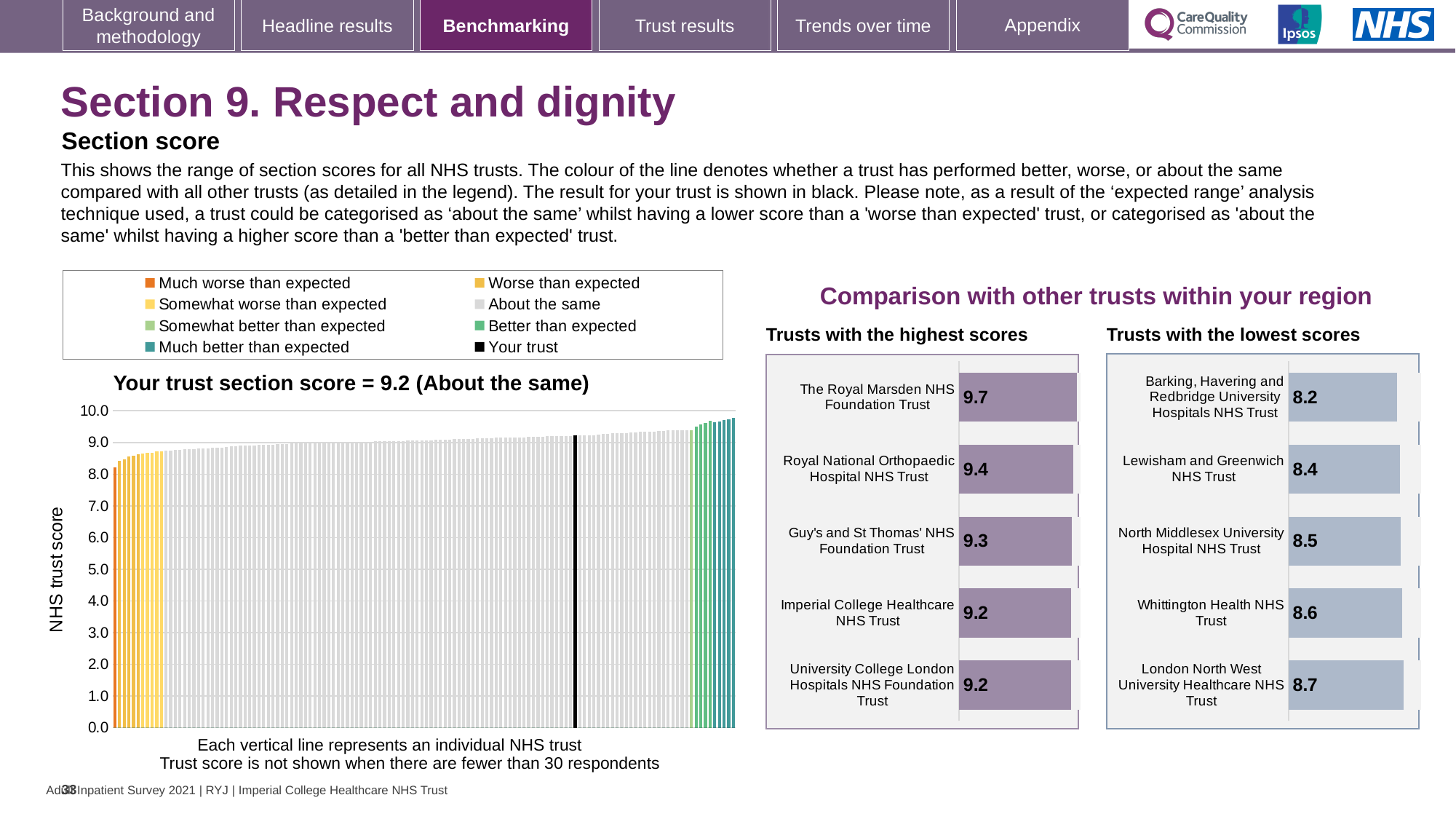
In the 'Your trust section score' chart on the left, what is the label on the vertical axis? NHS trust score In the 'Your trust section score' chart on the left, what is the section score for your trust? 9.2 In the 'Trusts with the highest scores' chart, what is the score for The Royal Marsden NHS Foundation Trust? 9.7 In the 'Trusts with the highest scores' chart, how many trusts are listed? 5 In the 'Trusts with the highest scores' chart, what is the difference between the scores of The Royal Marsden NHS Foundation Trust and Imperial College Healthcare NHS Trust? 0.5 In the 'Trusts with the lowest scores' chart, what is the score for Lewisham and Greenwich NHS Trust? 8.4 In the 'Your trust section score' chart on the left, what kind of chart is shown? Bar chart In the 'Trusts with the lowest scores' chart, which trust has the lowest score? Barking, Havering and Redbridge University Hospitals NHS Trust In the 'Your trust section score' chart on the left, how many entries does the legend list? 8 In the 'Trusts with the lowest scores' chart, which has the larger score: Whittington Health NHS Trust or North Middlesex University Hospital NHS Trust? Whittington Health NHS Trust In the 'Trusts with the highest scores' chart, which trust has the highest score? The Royal Marsden NHS Foundation Trust In the 'Trusts with the lowest scores' chart, what is the difference between the scores of London North West University Healthcare NHS Trust and Barking, Havering and Redbridge University Hospitals NHS Trust? 0.5